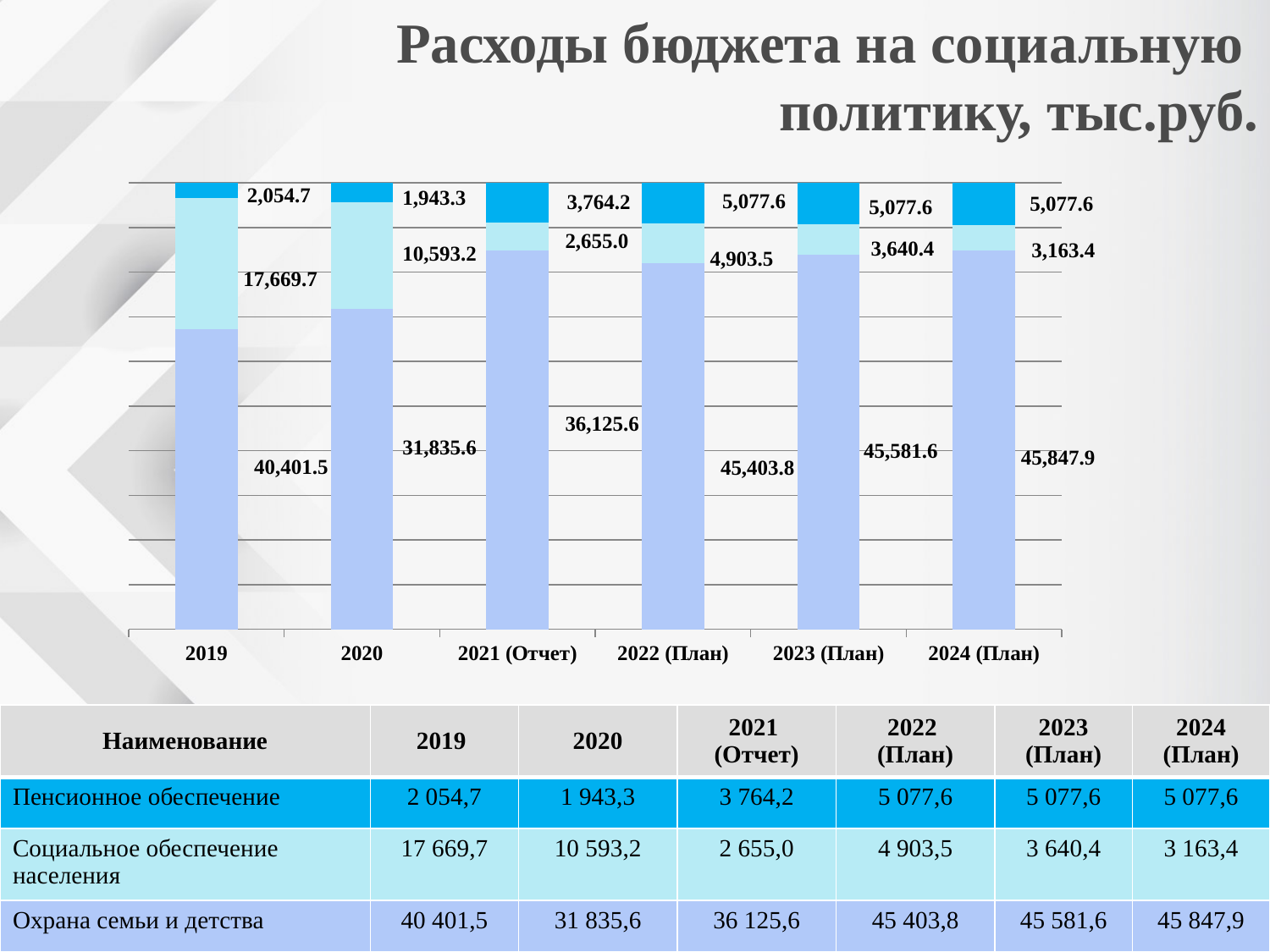
How many year categories are shown on the x axis of the chart? 6 What is the value of the top segment (Пенсионное обеспечение) for 2021 (Отчет)? 3,764.2 How many series are stacked in each bar of the chart? 3 In which year is the Социальное обеспечение населения segment the smallest? 2021 (Отчет) Which is larger: the Охрана семьи и детства value for 2021 (Отчет) or for 2022 (План)? 2022 (План) In which year is the Охрана семьи и детства segment the smallest? 2020 What is the value of the bottom segment (Охрана семьи и детства) for 2019? 40,401.5 What kind of chart is shown on the slide? stacked bar chart What is the value of the middle segment (Социальное обеспечение населения) for 2023 (План)? 3,640.4 By how much does the Социальное обеспечение населения value for 2019 exceed that for 2020? 7,076.5 In which year is the Охрана семьи и детства segment the largest? 2024 (План) What is the total of the stacked bar for 2019? 60,125.9